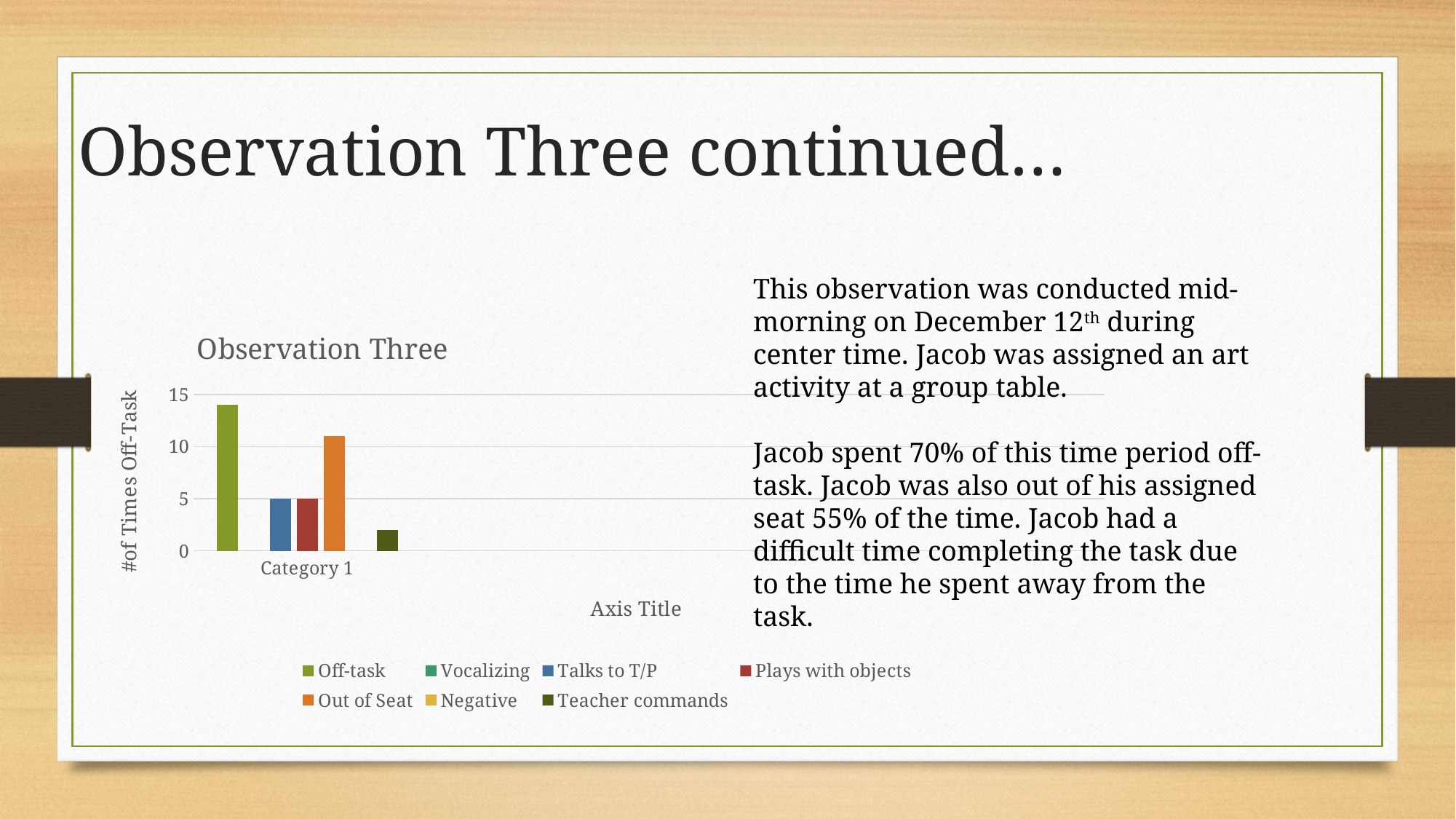
How many series does the legend of the chart list? 7 What kind of chart is shown on the slide? bar chart Which is larger, the value for Out of Seat or the value for Teacher commands? Out of Seat Which series has the highest bar in the chart? Off-task How many categories are shown on the x axis of the chart? 1 Is the value for Out of Seat greater or less than 15? less Which is larger, the value for Off-task or the value for Out of Seat? Off-task What is the title of the chart? Observation Three What is the label on the vertical axis of the chart? #of Times Off-Task Is the value for Off-task greater or less than 10? greater Is the value for Out of Seat greater or less than 10? greater